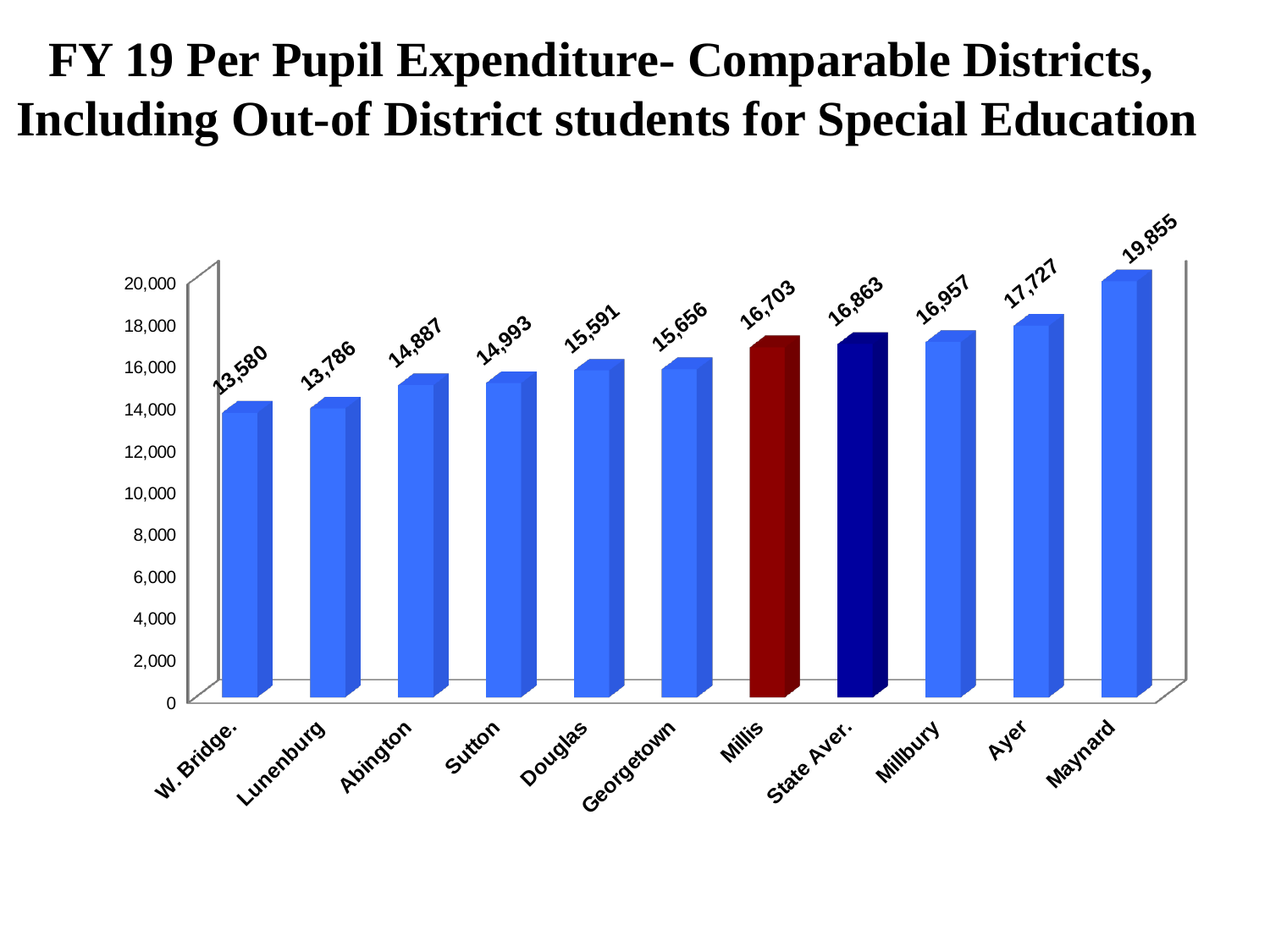
What is the difference between Maynard and W. Bridge.? 6,275 What is the per pupil expenditure for Sutton? 14,993 Which district has the highest per pupil expenditure? Maynard What is the difference between State Aver. and Millis? 160 What kind of chart is shown on the slide? bar chart Which bar is coloured dark red? Millis Which is larger, the value for Ayer or the value for Millbury? Ayer How many categories are shown on the x axis? 11 Is the value for Douglas greater or less than 14,000? greater Which district has the lowest per pupil expenditure? W. Bridge. What is the per pupil expenditure for Millis? 16,703 What is the value shown for State Aver.? 16,863